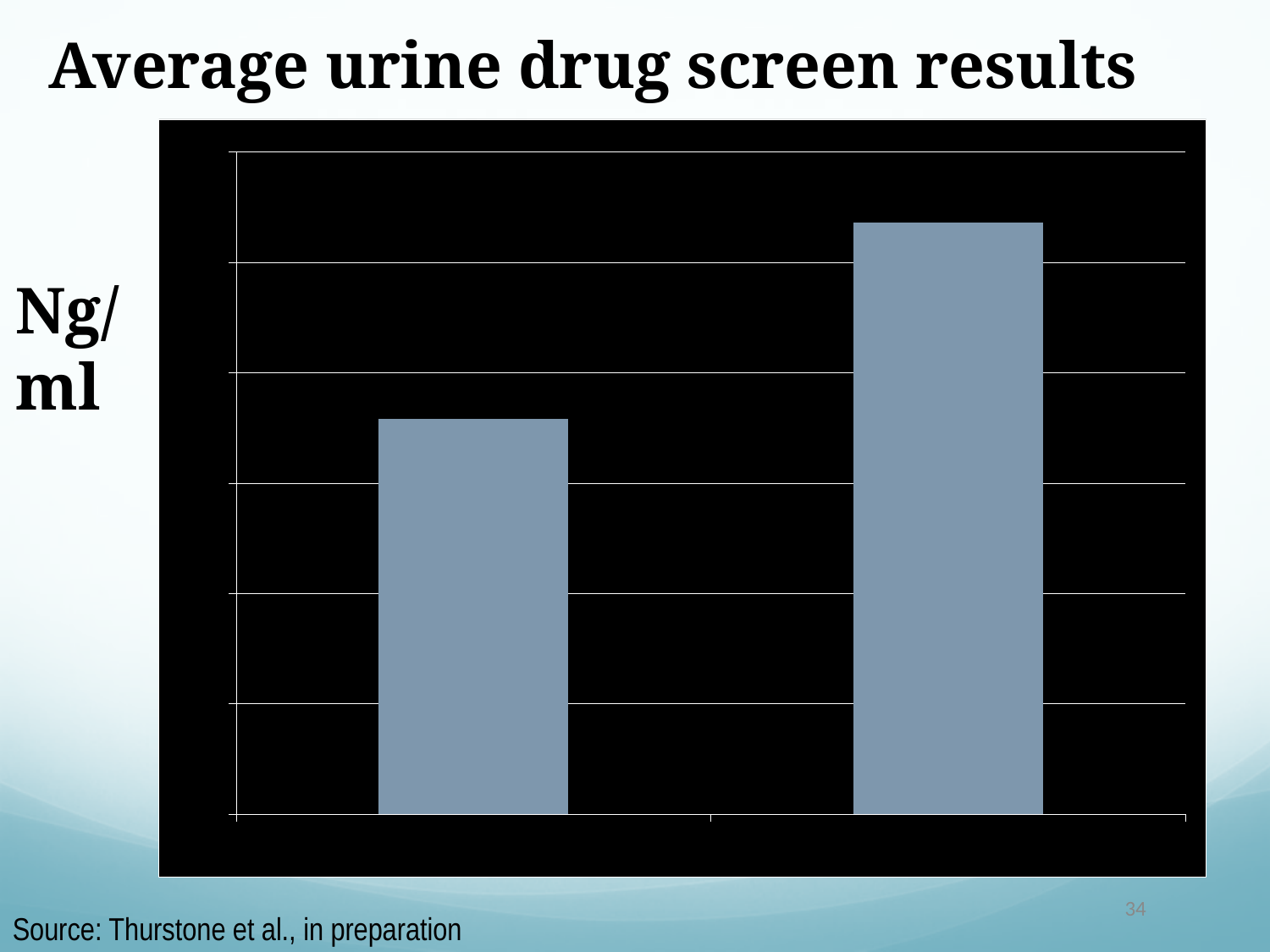
Which bar is taller, the left bar or the right bar? the right bar Do the bar values rise or fall from left to right? rise What kind of chart is shown on the slide? bar chart Which bar shows the highest value, the left or the right? the right bar What unit is shown as the vertical axis label next to the chart? Ng/ml How many bars are plotted in the chart? 2 Which bar shows the lowest value, the left or the right? the left bar What is the title of the chart on the slide? Average urine drug screen results